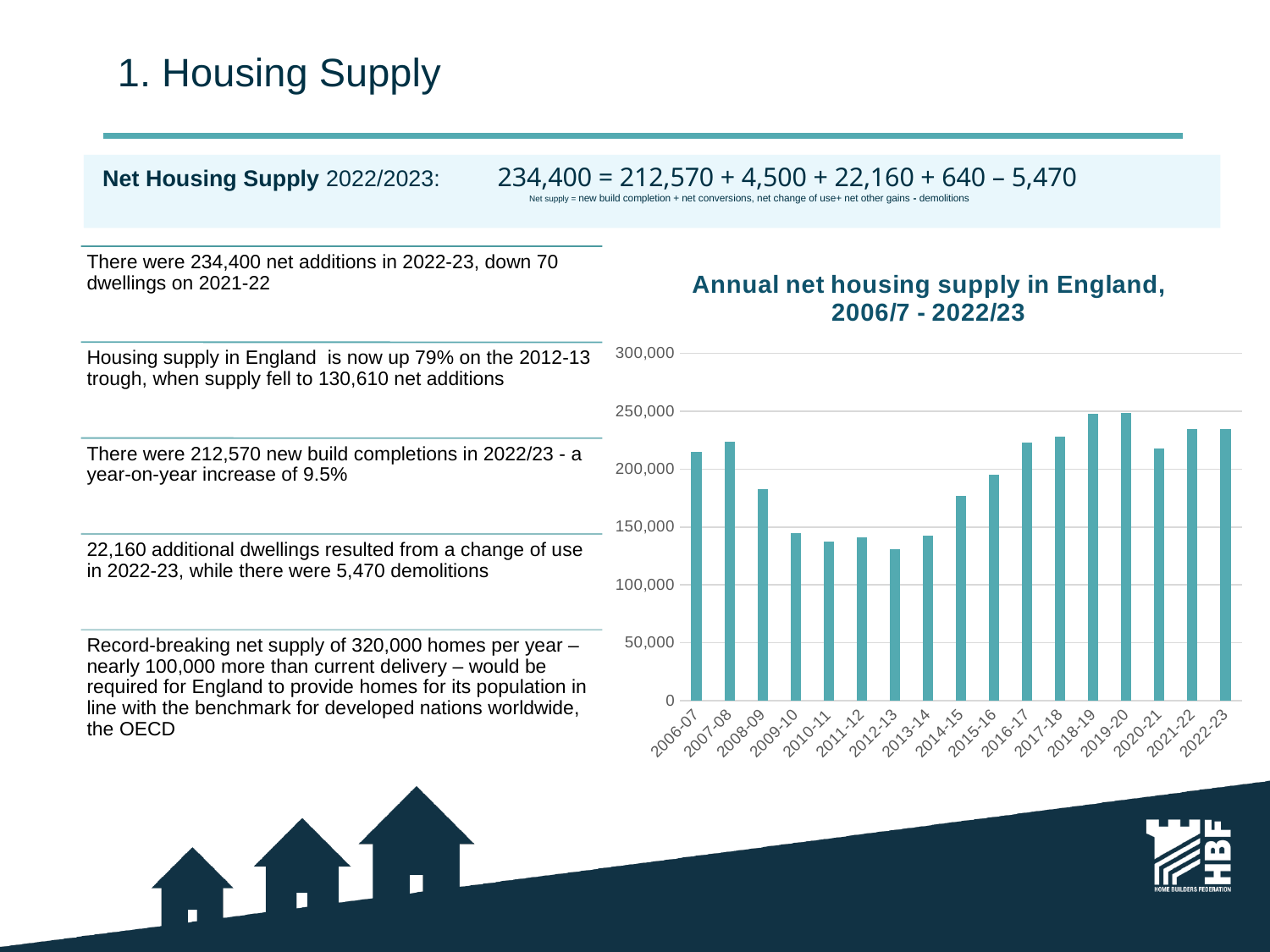
Is the value for 2010-11 greater or less than 150,000? less Do the values rise or fall from 2012-13 to 2019-20? Rise Which is larger, the value for 2007-08 or the value for 2008-09? 2007-08 Is the value for 2006-07 greater or less than 200,000? greater Which is larger, the value for 2020-21 or the value for 2021-22? 2021-22 How many years (bars) are plotted in the chart? 17 Which year has the lowest net housing supply in the chart? 2012-13 What kind of chart is shown on the slide? Bar chart What is the title of the chart? Annual net housing supply in England, 2006/7 - 2022/23 Do the values rise or fall from 2007-08 to 2012-13? Fall